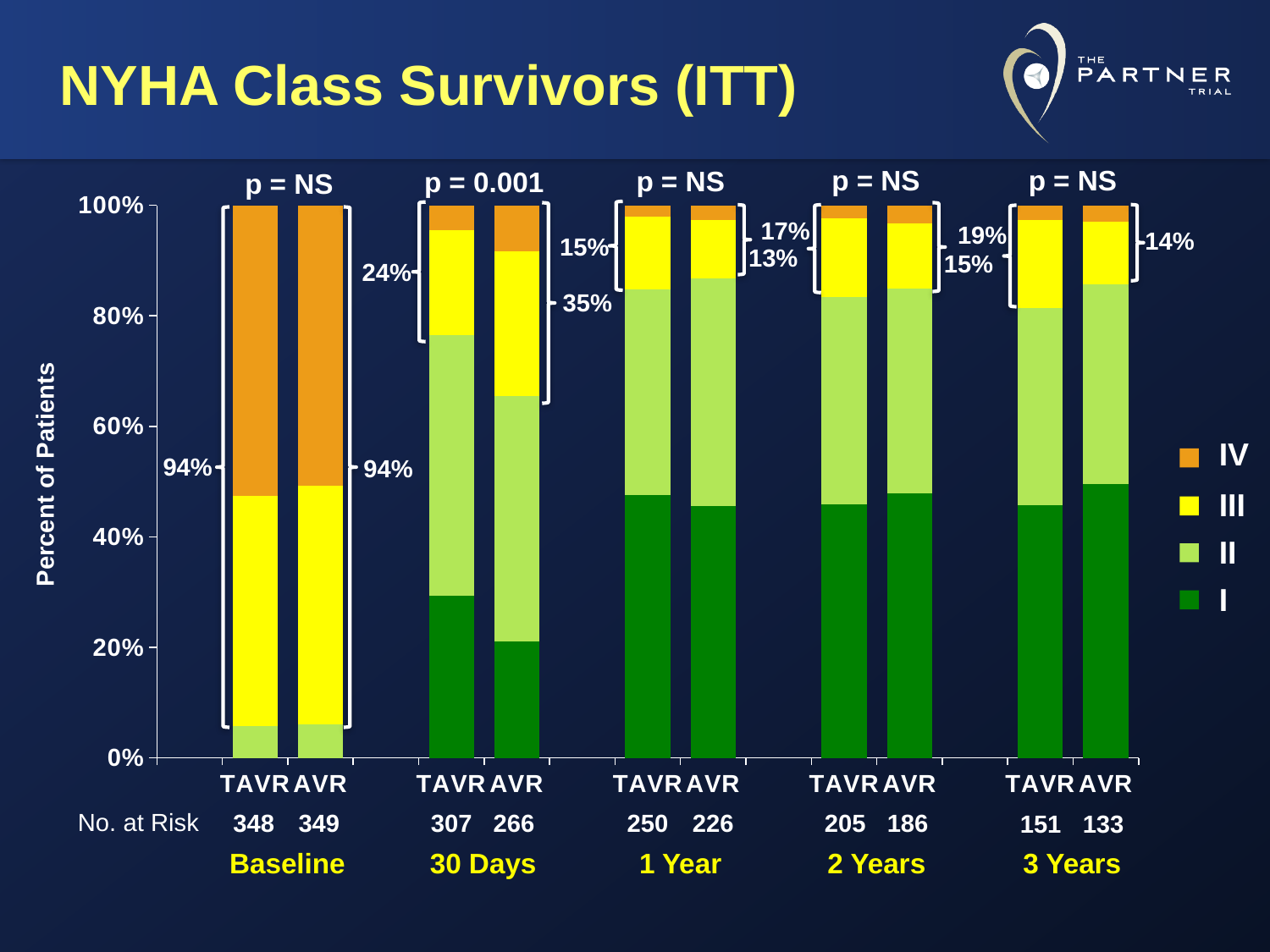
What is the difference in No. at Risk between TAVR and AVR at 1 Year? 24 What percentage of AVR patients are in NYHA class III or IV at 30 Days? 35% How many NYHA classes does the legend list? 4 At 30 Days, what is the difference between the AVR and TAVR shares of patients in NYHA class III or IV? 11% What is the No. at Risk for TAVR at Baseline? 348 What kind of chart is shown on the slide? Stacked bar chart At 30 Days, which group has the larger share of patients in NYHA class III or IV, TAVR or AVR? AVR What percentage of TAVR patients are in NYHA class III or IV at 30 Days? 24% What is the No. at Risk for AVR at 3 Years? 133 Is the share of TAVR patients in NYHA class I at 30 Days greater or less than 40%? less How many time points are shown along the x axis? 5 What p-value is shown for the 30 Days comparison? p = 0.001